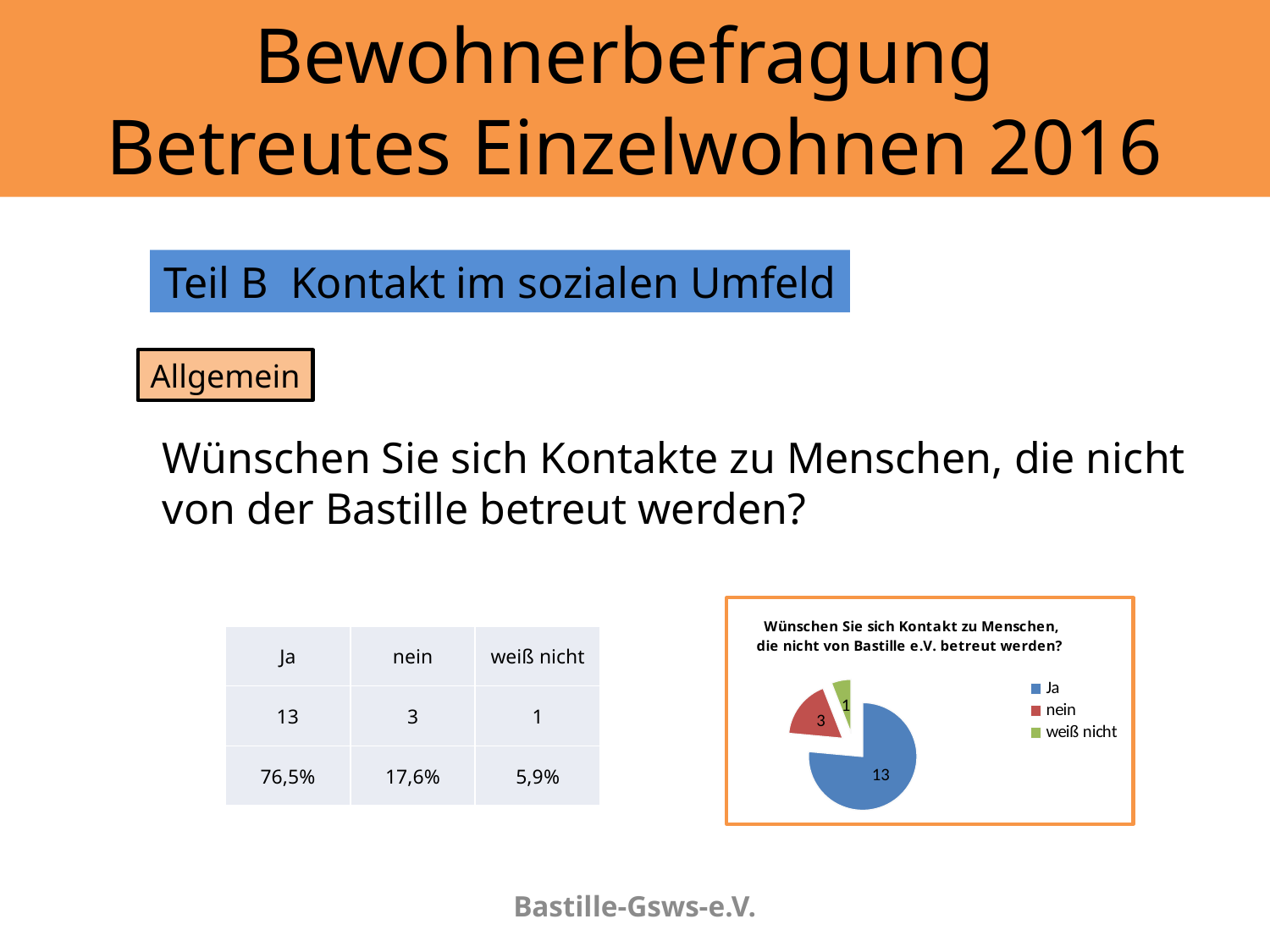
What kind of chart is shown on the slide? pie chart Which category has the largest slice in the pie chart? Ja What share of the pie does the "Ja" slice represent? 76,5% How many entries does the legend of the pie chart list? 3 What is the value for "nein" in the pie chart? 3 What colour is the "Ja" slice in the pie chart? blue How many slices does the pie chart have? 3 What is the difference between the values for "Ja" and "nein" in the pie chart? 10 Which category has the smallest slice in the pie chart? weiß nicht Which is larger in the pie chart, the value for "nein" or the value for "weiß nicht"? nein What is the value for "weiß nicht" in the pie chart? 1 What is the value for "Ja" in the pie chart? 13